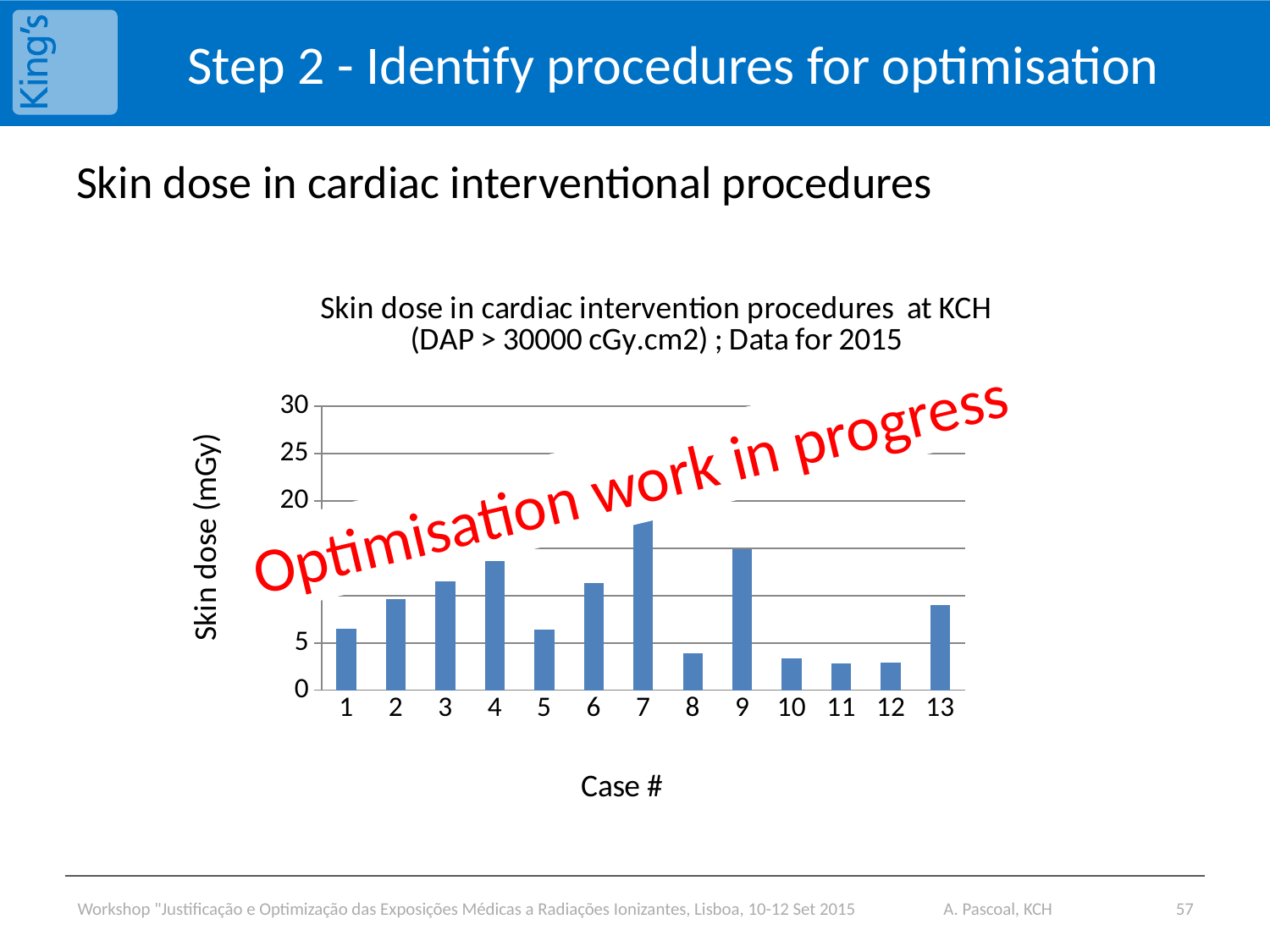
Which has the larger skin dose, case 2 or case 4? case 4 What kind of chart is shown on the slide? bar chart Which has the larger skin dose, case 7 or case 9? case 7 Is the skin dose for case 7 greater or less than 15 mGy? greater What is the label of the x axis of the chart? Case # Is the skin dose for case 4 greater or less than 10 mGy? greater Is the skin dose for case 10 greater or less than 5 mGy? less Which case has the highest skin dose? 7 What is the label of the y axis of the chart? Skin dose (mGy) How many cases are plotted on the x axis of the chart? 13